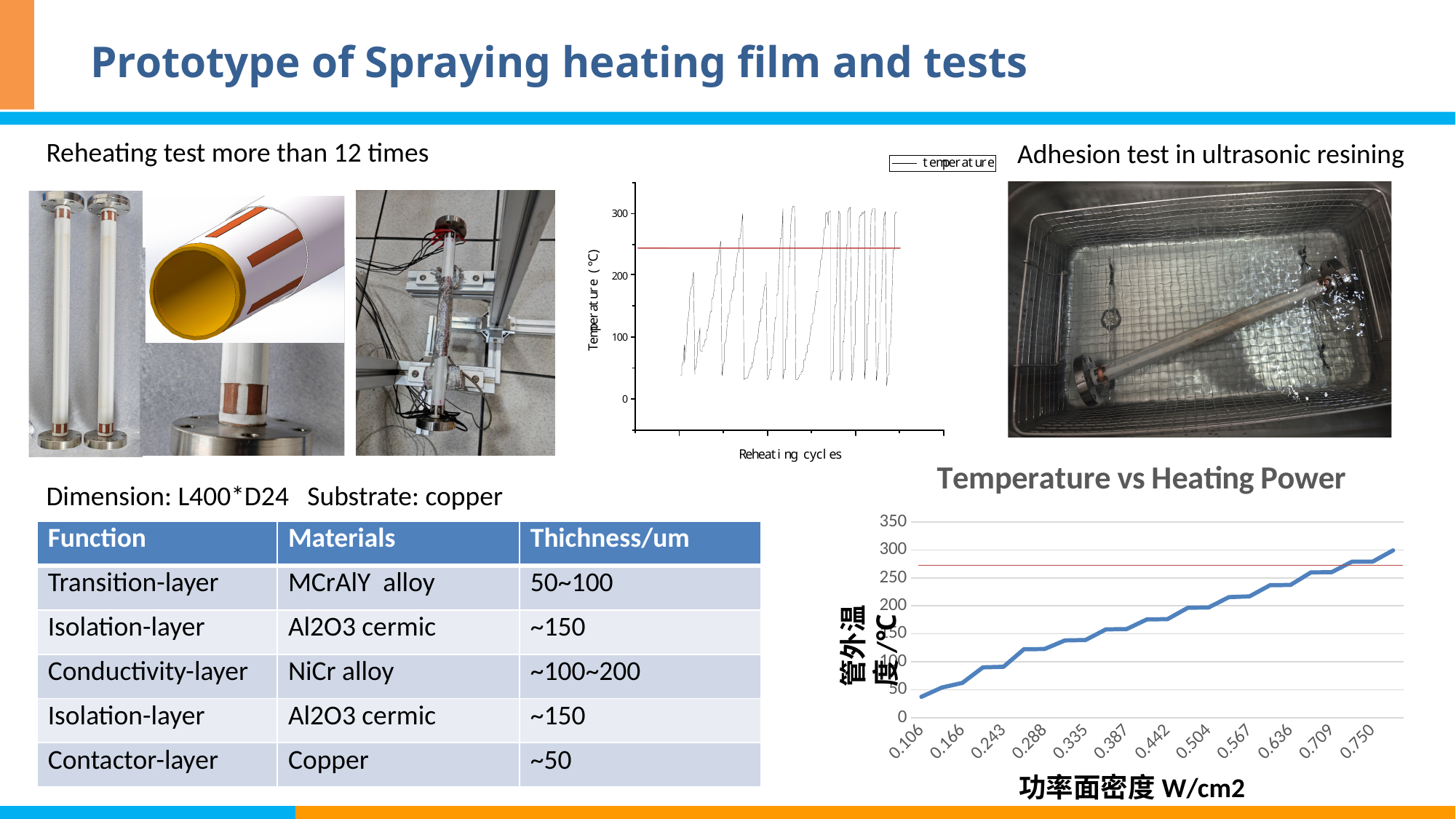
In the Temperature vs Heating Power chart, is the temperature at 0.106 greater or less than 50? less In the Temperature vs Heating Power chart, at which heating power value is the temperature lowest? 0.106 In the Temperature vs Heating Power chart, is the temperature at 0.288 greater or less than 100? greater In the Reheating cycles chart at the top of the slide, what is the y-axis label? Temperature (°C) In the Temperature vs Heating Power chart, is the temperature at 0.750 greater or less than 250? greater In the Temperature vs Heating Power chart, which has the higher temperature, 0.335 or 0.567? 0.567 In the Reheating cycles chart at the top of the slide, how many series does the legend list? 1 In the Temperature vs Heating Power chart, does the temperature rise or fall as heating power increases along the x axis? rise In the Temperature vs Heating Power chart, what is the x-axis title? 功率面密度 W/cm2 In the Temperature vs Heating Power chart, what kind of chart is shown? line chart